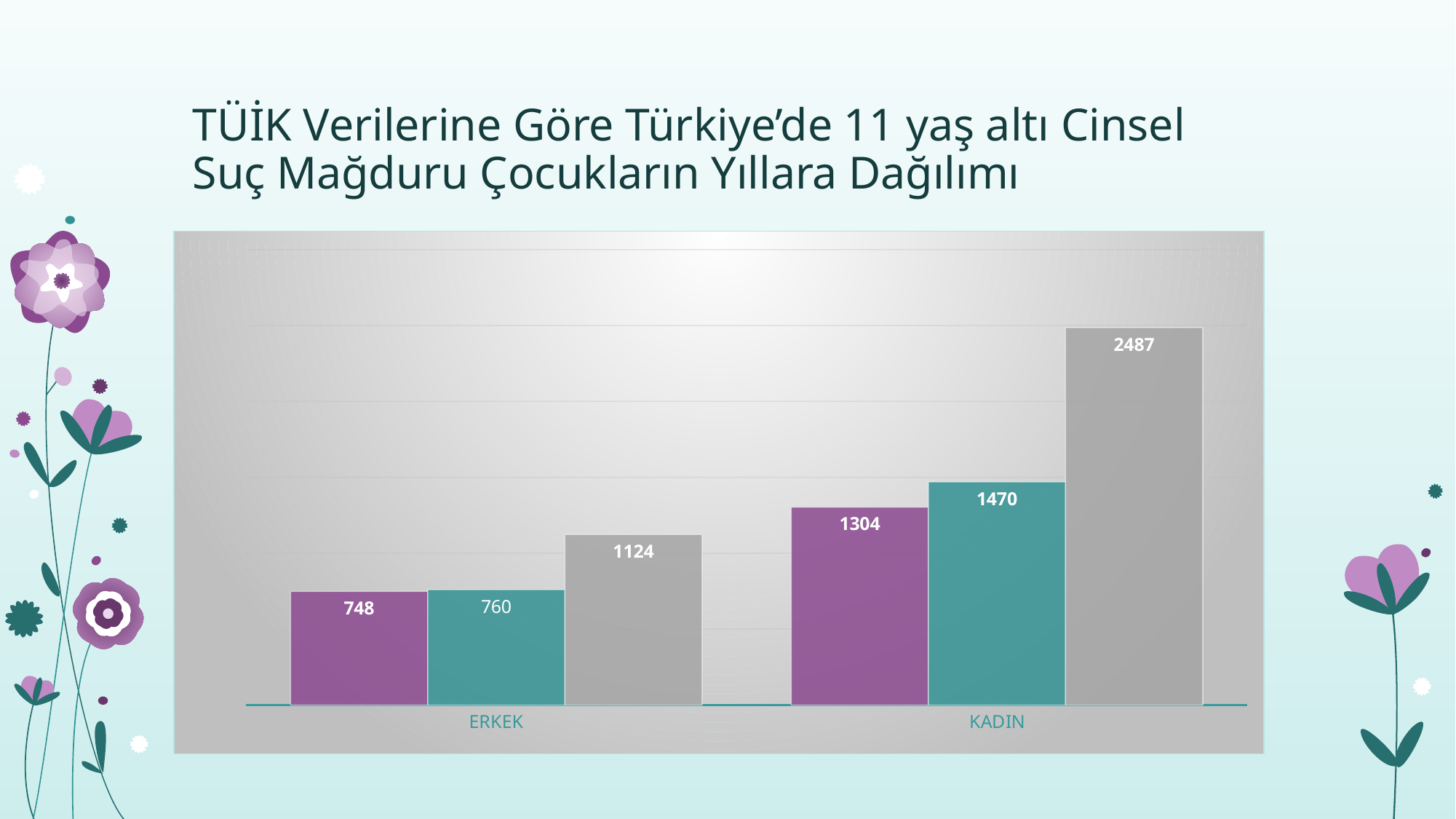
What is the difference between the grey bar for KADIN and the grey bar for ERKEK? 1363 What is the value of the grey bar for ERKEK? 1124 What is the value of the teal bar for KADIN? 1470 What is the difference between the teal bar for KADIN and the purple bar for KADIN? 166 Which bar has the highest value in the chart? the grey bar for KADIN (2487) Which is larger: the grey bar for ERKEK or the purple bar for KADIN? the purple bar for KADIN What is the value of the purple bar for KADIN? 1304 How many categories are shown on the x axis of the chart? 2 Which bar has the lowest value in the chart? the purple bar for ERKEK (748) How many bars are plotted for each category in the chart? 3 What type of chart is shown on the slide? bar chart What is the value of the purple bar for ERKEK? 748